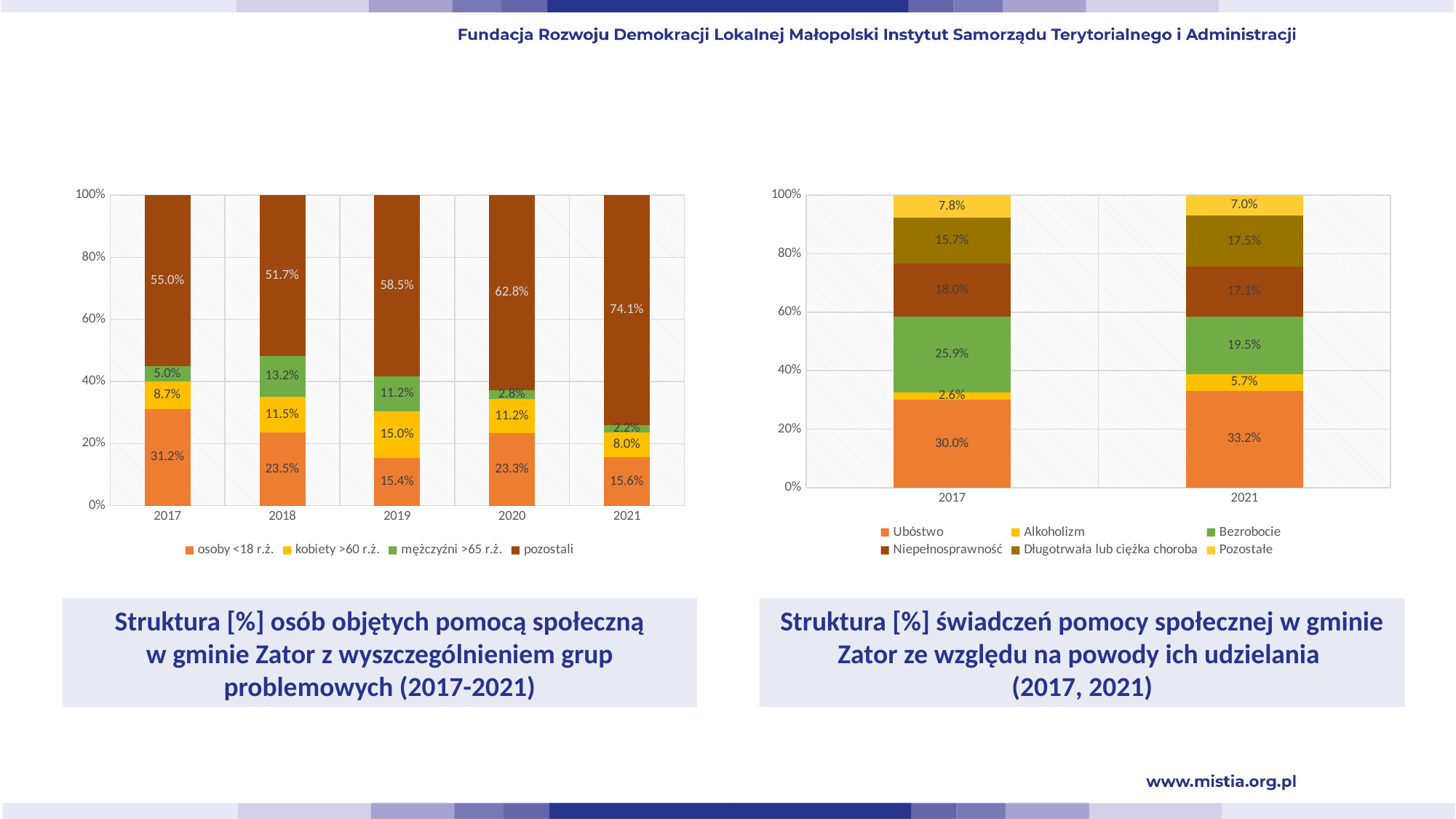
What type of chart is the right chart (Struktura [%] świadczeń pomocy społecznej)? Stacked bar chart In the left chart (Struktura [%] osób objętych pomocą społeczną), what is the value for 'pozostali' in 2021? 74.1% In the right chart (Struktura [%] świadczeń pomocy społecznej), what is the value for 'Bezrobocie' in 2017? 25.9% In the left chart (Struktura [%] osób objętych pomocą społeczną), how many series does the legend list? 4 In the left chart (Struktura [%] osób objętych pomocą społeczną), what is the difference between the 'kobiety >60 r.ż.' values in 2019 and 2021? 7.0% In the left chart (Struktura [%] osób objętych pomocą społeczną), in which year is the 'mężczyźni >65 r.ż.' share highest? 2018 In the left chart (Struktura [%] osób objętych pomocą społeczną), how many years are shown on the x axis? 5 In the right chart (Struktura [%] świadczeń pomocy społecznej), what is the difference between the 'Bezrobocie' values in 2017 and 2021? 6.4% In the right chart (Struktura [%] świadczeń pomocy społecznej), which is larger: 'Ubóstwo' in 2017 or 'Ubóstwo' in 2021? 2021 In the right chart (Struktura [%] świadczeń pomocy społecznej), how many series does the legend list? 6 In the left chart (Struktura [%] osób objętych pomocą społeczną), what is the value for 'osoby <18 r.ż.' in 2017? 31.2% In the left chart (Struktura [%] osób objętych pomocą społeczną), in which year is the 'pozostali' share lowest? 2018